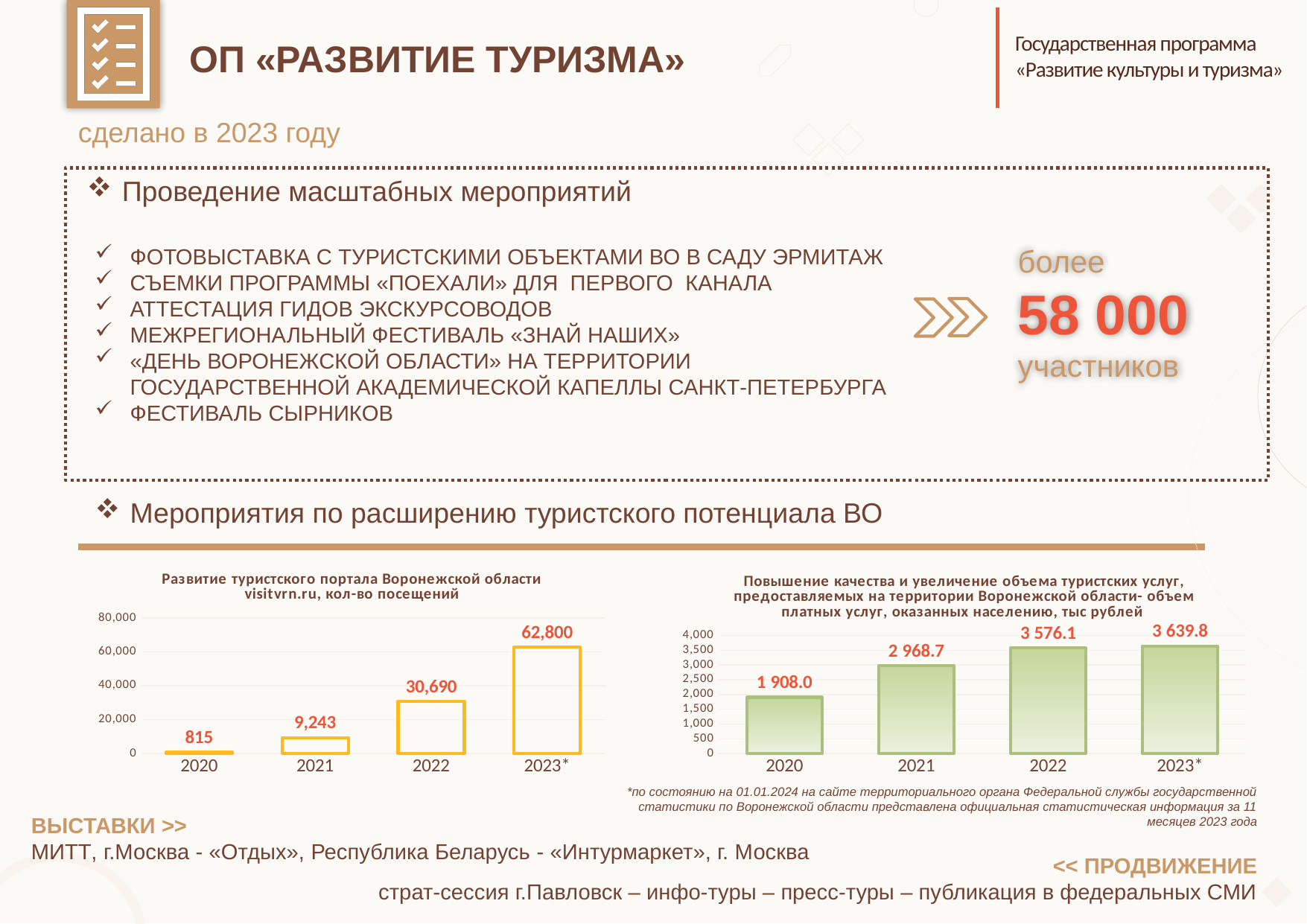
На левой диаграмме «Развитие туристского портала Воронежской области visitvrn.ru» значение 2021 года больше или меньше 20,000? меньше Сколько категорий (лет) показано на правой диаграмме «Повышение качества и увеличение объема туристских услуг»? 4 На левой диаграмме «Развитие туристского портала Воронежской области visitvrn.ru» значения растут или падают с 2020 по 2023* год? растут На левой диаграмме «Развитие туристского портала Воронежской области visitvrn.ru» в каком году значение наибольшее? 2023* На правой диаграмме «Повышение качества и увеличение объема туристских услуг» в каком году значение наименьшее? 2020 На левой диаграмме «Развитие туристского портала Воронежской области visitvrn.ru» на сколько значение 2023* года больше значения 2022 года? 32,110 На правой диаграмме «Повышение качества и увеличение объема туристских услуг» на сколько значение 2021 года больше значения 2020 года? 1 060.7 На левой диаграмме «Развитие туристского портала Воронежской области visitvrn.ru» какое значение указано для 2020 года? 815 На правой диаграмме «Повышение качества и увеличение объема туристских услуг» какое значение указано для 2021 года? 2 968.7 На правой диаграмме «Повышение качества и увеличение объема туристских услуг» какое значение больше: 2022 или 2023*? 2023* Какого типа левая диаграмма «Развитие туристского портала Воронежской области visitvrn.ru»? столбчатая (bar chart) На левой диаграмме «Развитие туристского портала Воронежской области visitvrn.ru» какое значение указано для 2022 года? 30,690